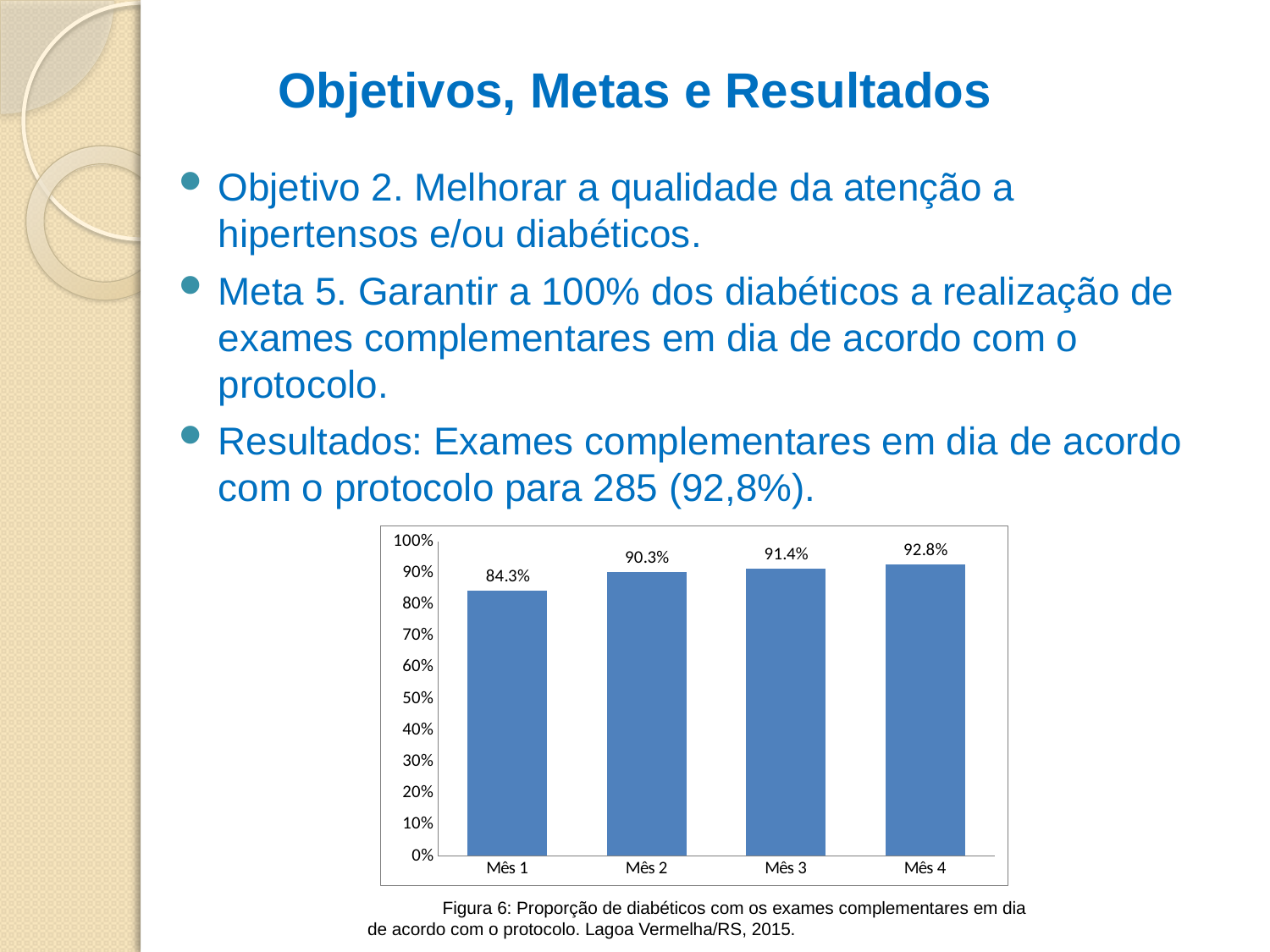
Which month has the lowest value? Mês 1 Which is larger, the value for Mês 2 or the value for Mês 1? Mês 2 How many months are shown on the x axis? 4 Which month has the highest value? Mês 4 What is the value for Mês 3? 91.4% What is the value for Mês 1? 84.3% Do the values rise or fall from Mês 1 to Mês 4? rise What is the difference between the values for Mês 4 and Mês 1? 8.5% What is the value for Mês 4? 92.8% Is the value for Mês 1 greater or less than 90%? less What is the difference between the values for Mês 2 and Mês 1? 6.0% What kind of chart is shown on the slide? bar chart